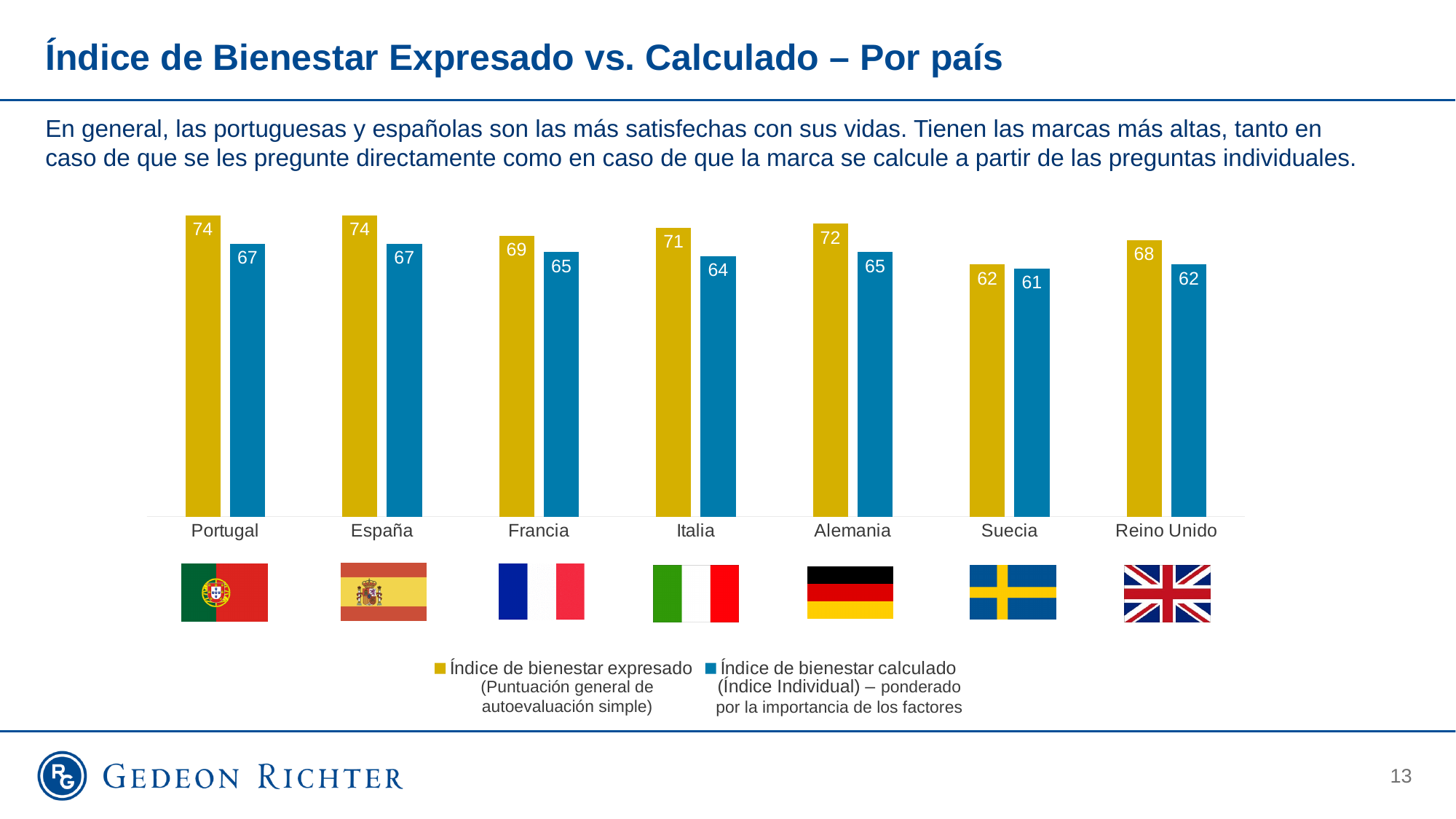
How many countries are shown on the chart? 7 Which country has the lowest Índice de bienestar calculado? Suecia What is the difference between the Índice de bienestar expresado for Portugal and for Reino Unido? 6 What is the value of Índice de bienestar expresado for Alemania? 72 Which colour represents the Índice de bienestar calculado series? Blue Which is larger: the Índice de bienestar calculado for Francia or for Reino Unido? Francia What kind of chart is shown on the slide? Bar chart What is the difference between the Índice de bienestar expresado and the Índice de bienestar calculado for Alemania? 7 What is the value of Índice de bienestar calculado for Italia? 64 What is the value of Índice de bienestar expresado for Francia? 69 How many series does the legend list? 2 Which country has the lowest Índice de bienestar expresado? Suecia